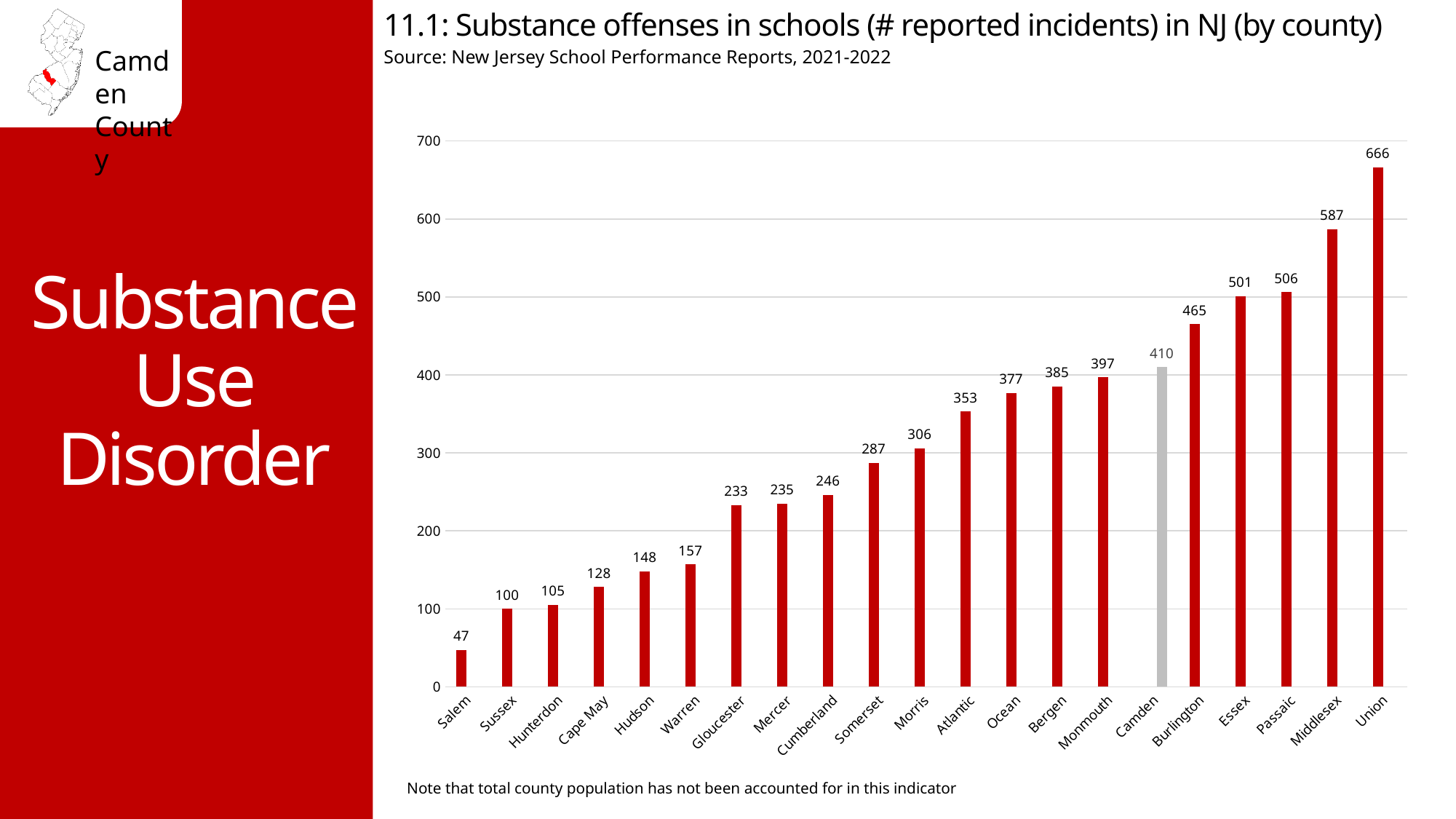
Is the value for Burlington greater or less than 400? greater How many counties are shown on the chart? 21 Which county has the highest number of reported incidents? Union Which bar is shown in a different colour (grey) from the others? Camden Which county has the lowest number of reported incidents? Salem Do the values rise or fall from left to right along the x axis? Rise What is the value shown for Hudson County? 148 What is the difference between the values for Union and Middlesex? 79 What kind of chart is shown on the slide? Bar chart Which county has a larger value, Bergen or Ocean? Bergen What is the value shown for Union County? 666 What is the number of reported substance offense incidents in schools for Camden County? 410